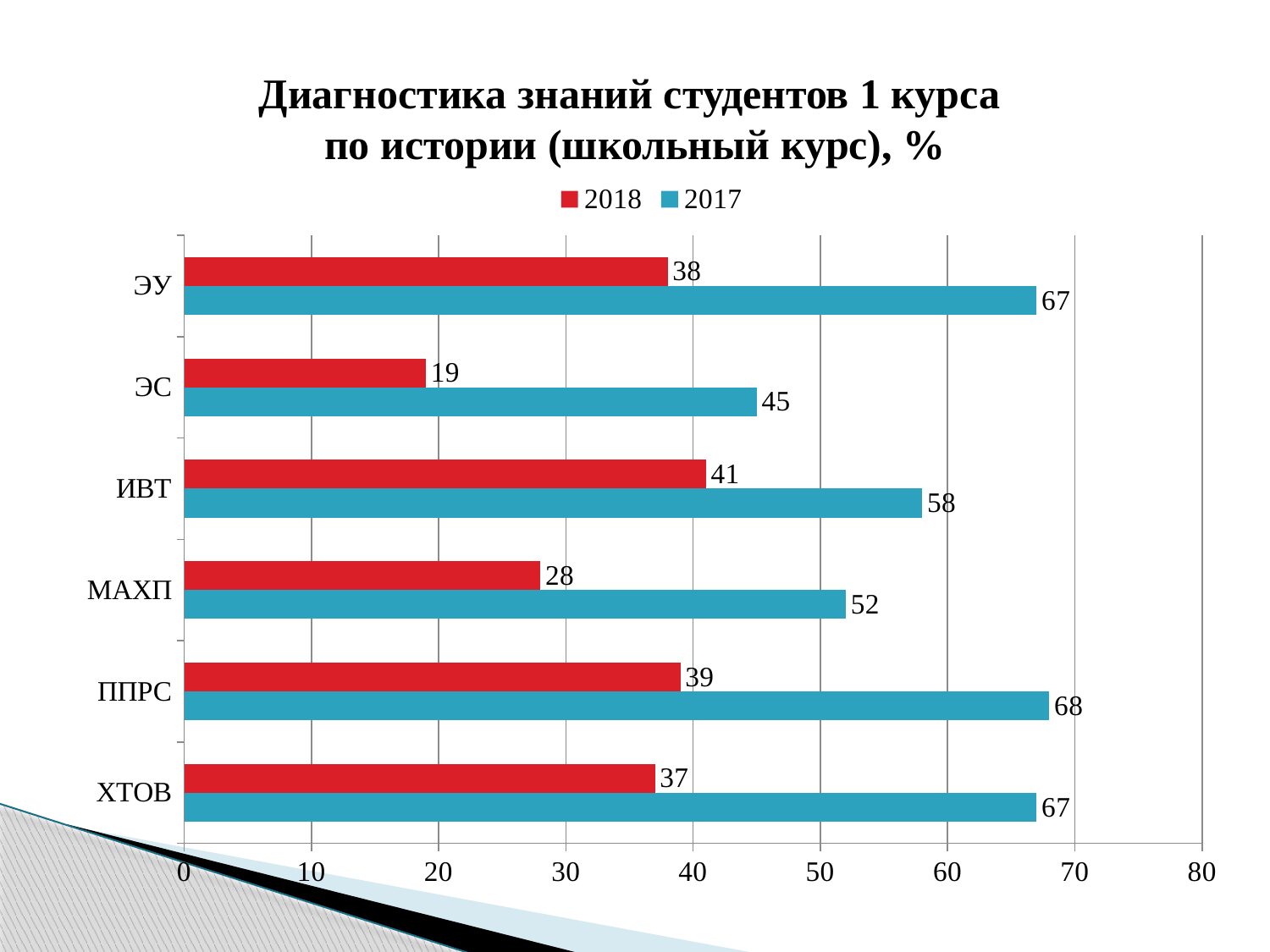
What is the difference between the 2017 and 2018 values for ИВТ? 17 How many series does the legend list? 2 Which category has the highest 2017 value? ППРС Which category has the lowest 2018 value? ЭС What kind of chart is shown on the slide? bar chart What is the 2018 value for ППРС? 39 How many categories are shown on the chart? 6 What is the 2018 value for ЭУ? 38 Which colour represents the 2018 series? red What is the 2017 value for ЭС? 45 What is the 2017 value for МАХП? 52 Which is larger for ХТОВ: the 2017 value or the 2018 value? 2017